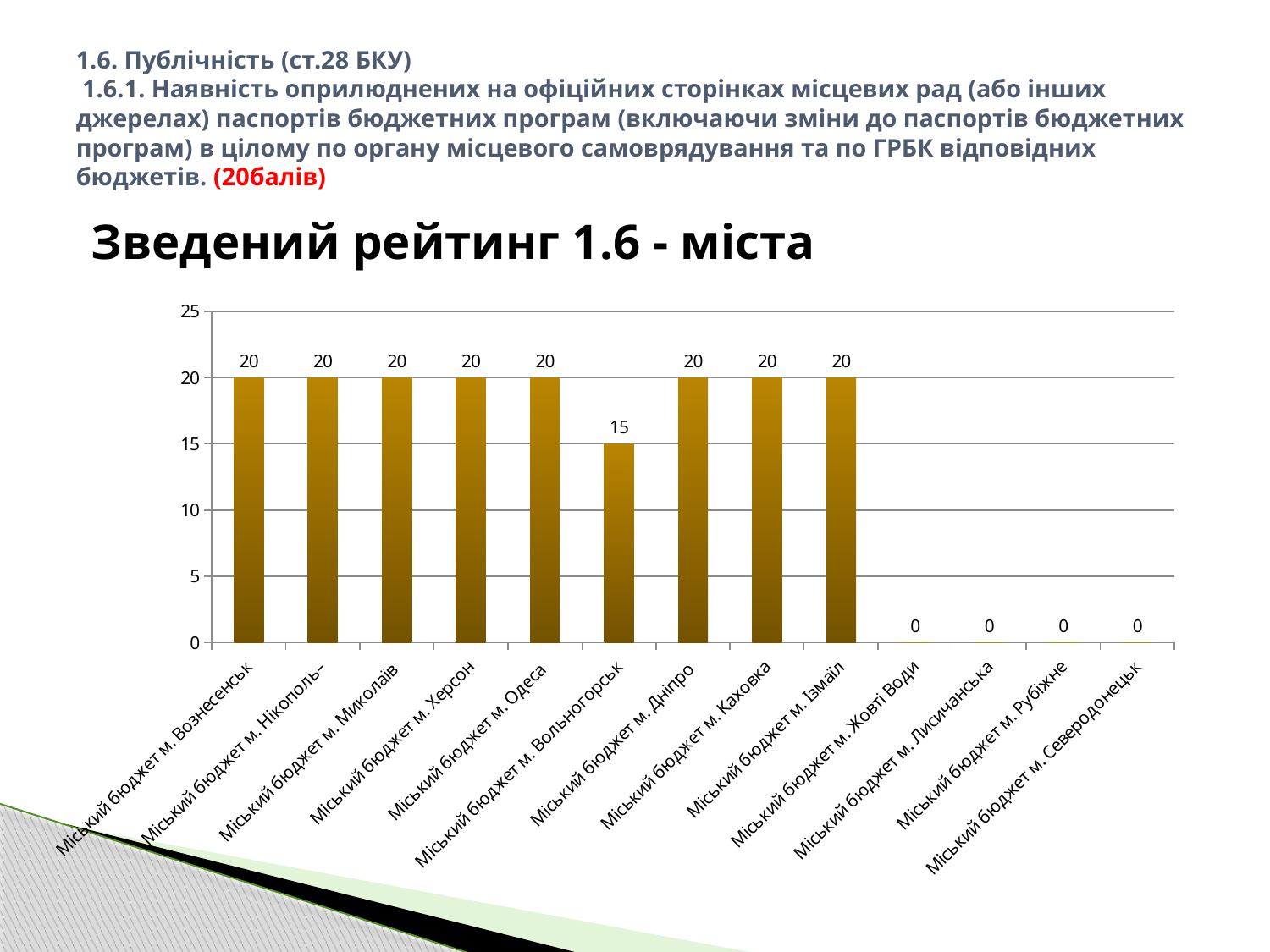
What is the value for Міський бюджет м. Ізмаїл? 20 Which has the larger value, Міський бюджет м. Вольногорськ or Міський бюджет м. Рубіжне? Міський бюджет м. Вольногорськ How many categories are shown on the x axis of the chart? 13 How many categories have a value of 20? 8 What is the value for Міський бюджет м. Одеса? 20 What is the value for Міський бюджет м. Сєверодонецьк? 0 What is the value for Міський бюджет м. Жовті Води? 0 Which has the larger value, Міський бюджет м. Херсон or Міський бюджет м. Вольногорськ? Міський бюджет м. Херсон What is the value for Міський бюджет м. Вольногорськ? 15 What is the difference between the values for Міський бюджет м. Дніпро and Міський бюджет м. Вольногорськ? 5 What type of chart is shown on the slide? bar chart What is the title of the chart? Зведений рейтинг 1.6 - міста